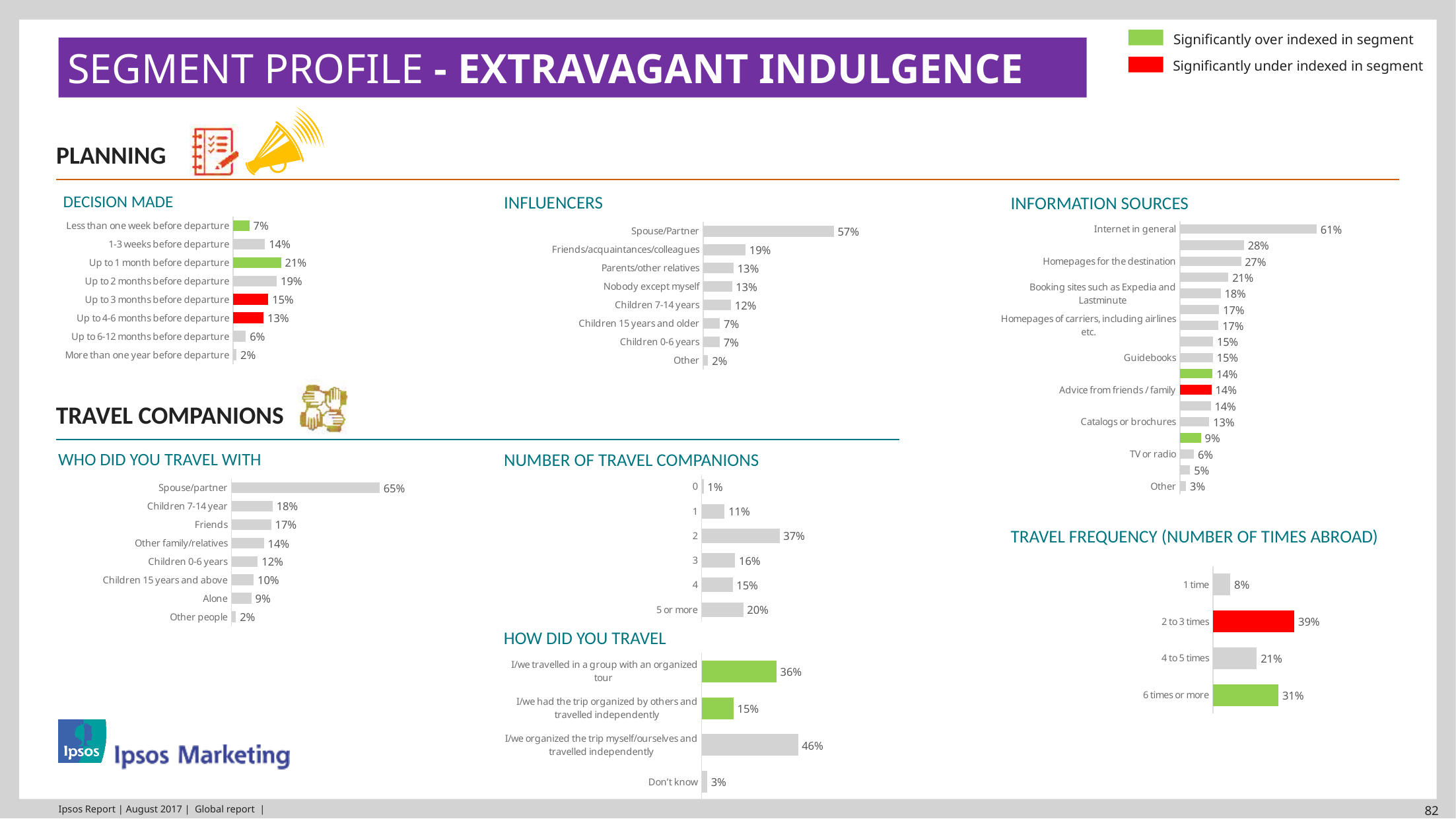
In the DECISION MADE chart, which category has the lowest value? More than one year before departure In the INFORMATION SOURCES chart, what is the value for "Internet in general"? 61% In the HOW DID YOU TRAVEL chart, what is the value for "I/we organized the trip myself/ourselves and travelled independently"? 46% In the TRAVEL FREQUENCY (NUMBER OF TIMES ABROAD) chart, what is the difference between "2 to 3 times" and "6 times or more"? 8 percentage points In the WHO DID YOU TRAVEL WITH chart, what is the value for Alone? 9% In the NUMBER OF TRAVEL COMPANIONS chart, which category has the highest value? 2 In the DECISION MADE chart, what is the value for "Up to 1 month before departure"? 21% In the INFORMATION SOURCES chart, which is larger: Guidebooks or TV or radio? Guidebooks In the INFLUENCERS chart, what is the difference between Spouse/Partner and Friends/acquaintances/colleagues? 38 percentage points What type of chart is the TRAVEL FREQUENCY (NUMBER OF TIMES ABROAD) chart? Bar chart In the INFLUENCERS chart, what is the value for Spouse/Partner? 57% In the WHO DID YOU TRAVEL WITH chart, how many categories are shown? 8